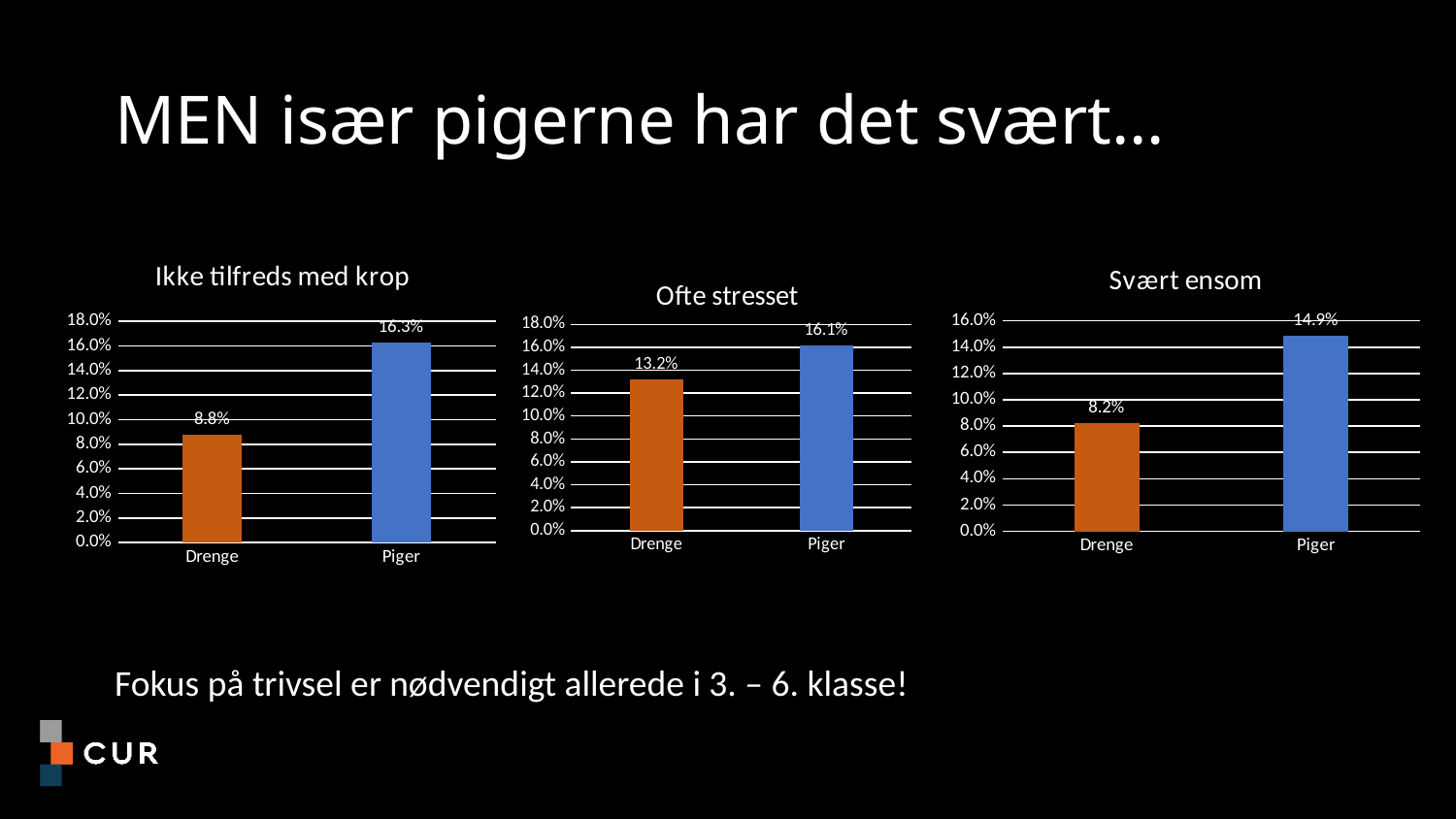
In the 'Ofte stresset' chart, what is the value for Drenge? 13.2% What kind of chart is the 'Ikke tilfreds med krop' chart? Bar chart In the 'Svært ensom' chart, what is the value for Piger? 14.9% In the 'Ikke tilfreds med krop' chart, what is the value for Piger? 16.3% In the 'Ikke tilfreds med krop' chart, what is the difference between the values for Piger and Drenge? 7.5% In the 'Svært ensom' chart, which category has the lowest value? Drenge In the 'Ofte stresset' chart, is the value for Drenge greater or less than 10.0%? greater In the 'Svært ensom' chart, what is the difference between the values for Piger and Drenge? 6.7% In the 'Ofte stresset' chart, which is larger, the value for Drenge or the value for Piger? Piger How many categories are shown in the 'Svært ensom' chart? 2 In the 'Ikke tilfreds med krop' chart, what is the value for Drenge? 8.8% In the 'Ofte stresset' chart, which category has the highest value? Piger